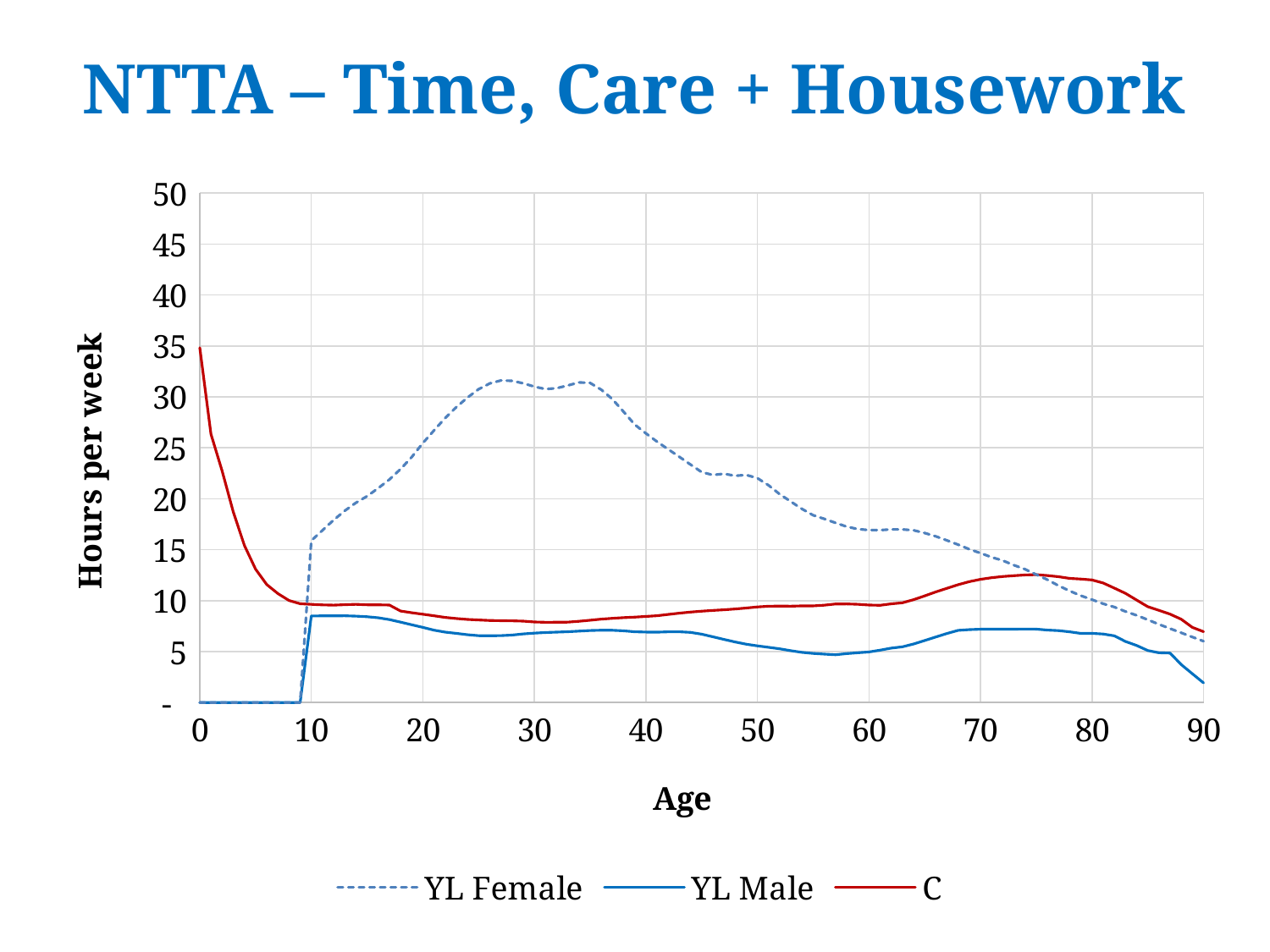
What is the title of the vertical axis? Hours per week Does the C series rise or fall between age 0 and age 10? fall At age 5, which series has the higher value, C or YL Female? C Is the value for C at age 0 greater or less than 30? greater Is the value for YL Female at age 20 greater or less than 20? greater Is the value for YL Male at age 50 greater or less than 10? less At age 30, which series has the higher value, YL Female or YL Male? YL Female Which series reaches the highest value anywhere on the chart? C How many series does the legend list? 3 What are the three series named in the legend? YL Female, YL Male, C What kind of chart is shown on the slide? line chart